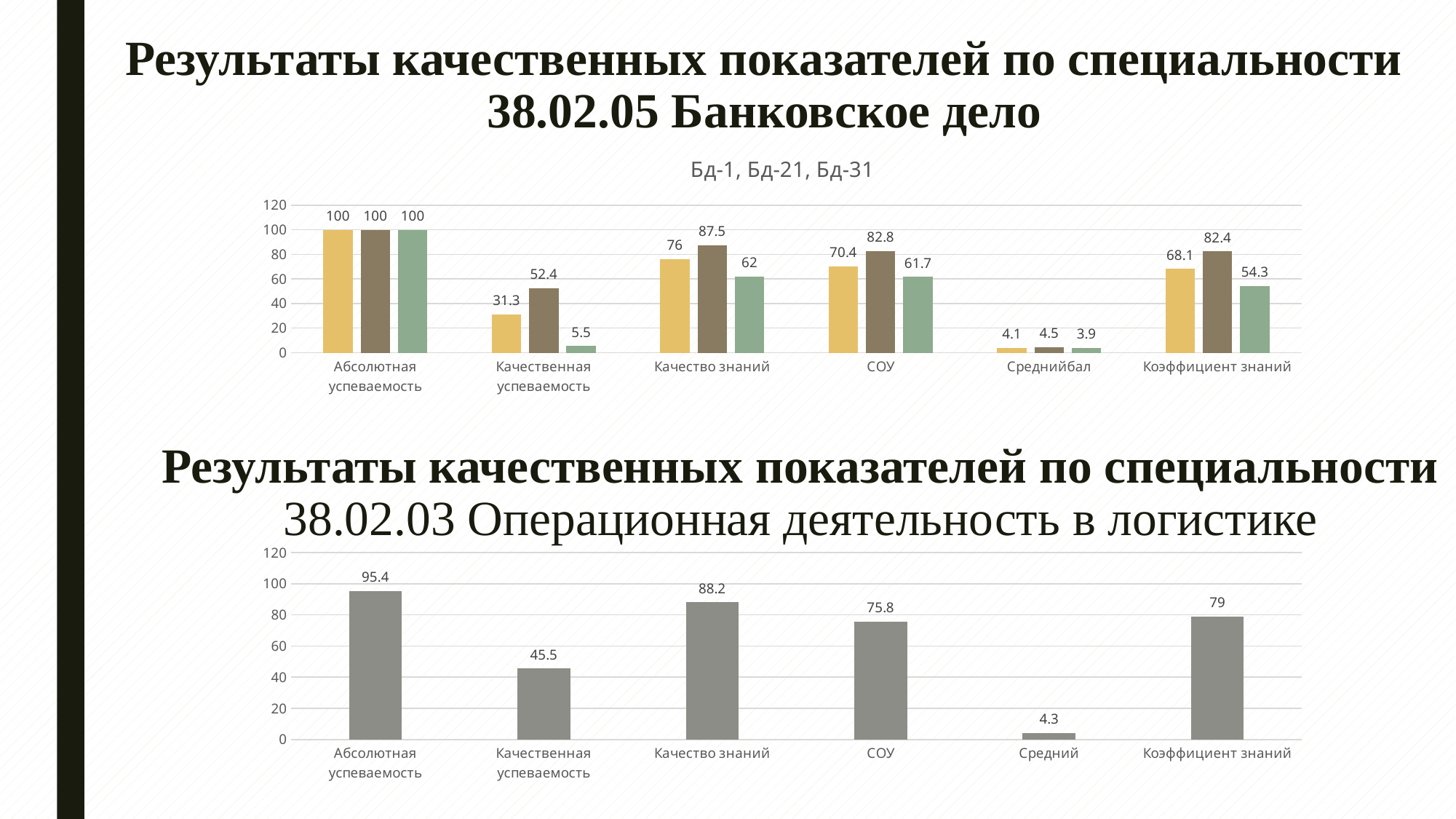
In the bottom chart (38.02.03 Операционная деятельность в логистике), which is larger: СОУ or Коэффициент знаний? Коэффициент знаний In the top chart (Бд-1, Бд-21, Бд-31), what is the value of the green bar for Качественная успеваемость? 5.5 In the top chart (Бд-1, Бд-21, Бд-31), which category has the lowest values for all three bars? Среднийбал In the top chart (Бд-1, Бд-21, Бд-31), how many categories are shown on the x axis? 6 In the top chart (Бд-1, Бд-21, Бд-31), what is the value of the brown bar for Качество знаний? 87.5 In the bottom chart (38.02.03 Операционная деятельность в логистике), what is the difference between Абсолютная успеваемость and Качественная успеваемость? 49.9 In the top chart (Бд-1, Бд-21, Бд-31), how many bars are shown for each category? 3 In the bottom chart (38.02.03 Операционная деятельность в логистике), what is the value for Качество знаний? 88.2 In the top chart (Бд-1, Бд-21, Бд-31), what is the difference between the brown and yellow bars for СОУ? 12.4 In the top chart (Бд-1, Бд-21, Бд-31), what is the value of the yellow bar for Коэффициент знаний? 68.1 What type of chart is the bottom chart (38.02.03 Операционная деятельность в логистике)? Bar chart In the bottom chart (38.02.03 Операционная деятельность в логистике), which category has the highest value? Абсолютная успеваемость